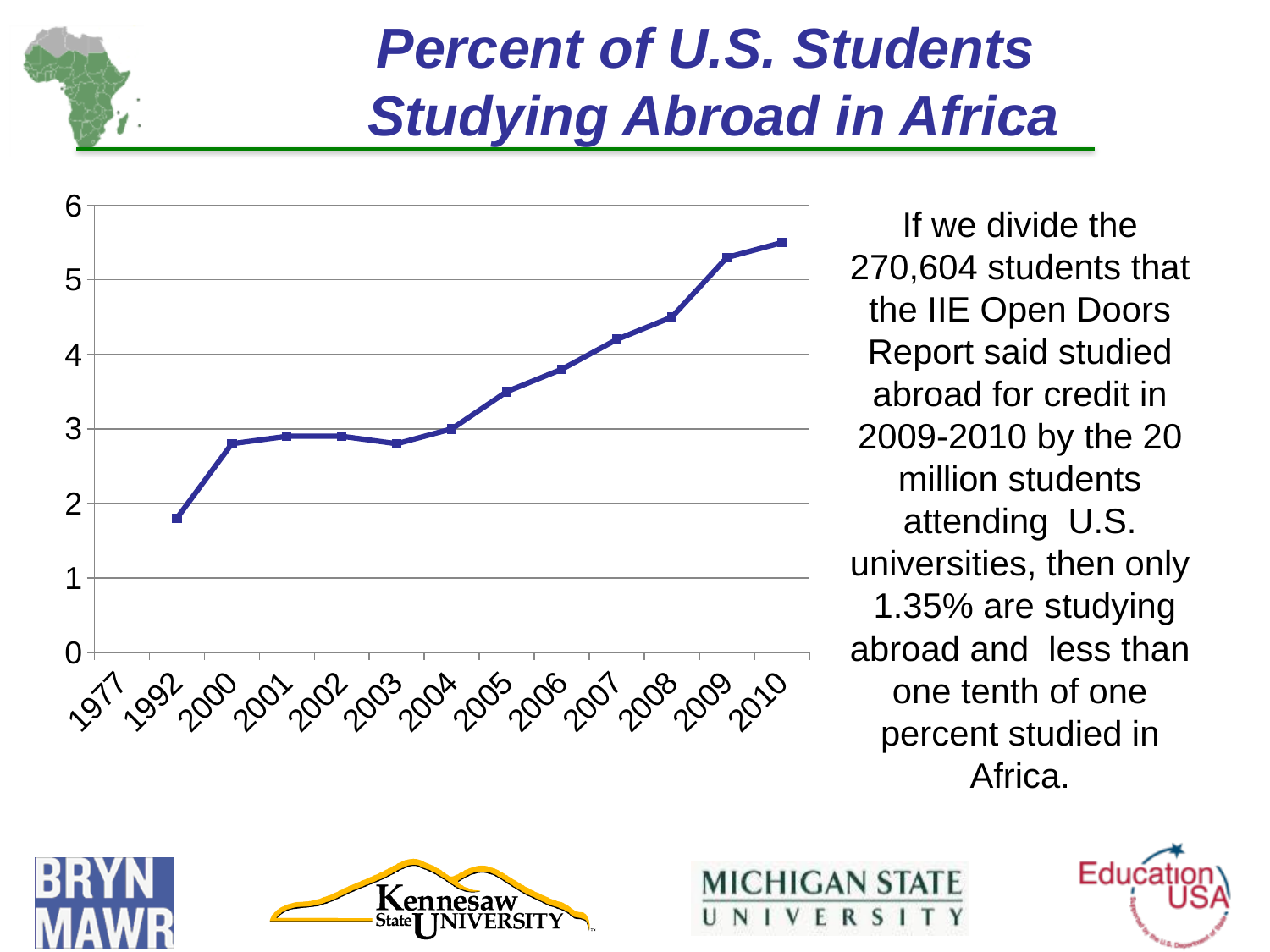
Is the value for 2010 greater or less than 5? greater What is the title of the chart? Percent of U.S. Students Studying Abroad in Africa Which plotted year has the lowest value on the chart? 1992 What kind of chart is shown on the slide? line chart How many year labels are shown on the x axis of the chart? 13 Do the values generally rise or fall from 1992 to 2010? rise Is the value for 2005 greater or less than 3? greater Which year has the highest value on the chart? 2010 Which year has the larger value, 2005 or 2009? 2009 Is the value for 2008 greater or less than 5? less What is the highest tick value shown on the y axis? 6